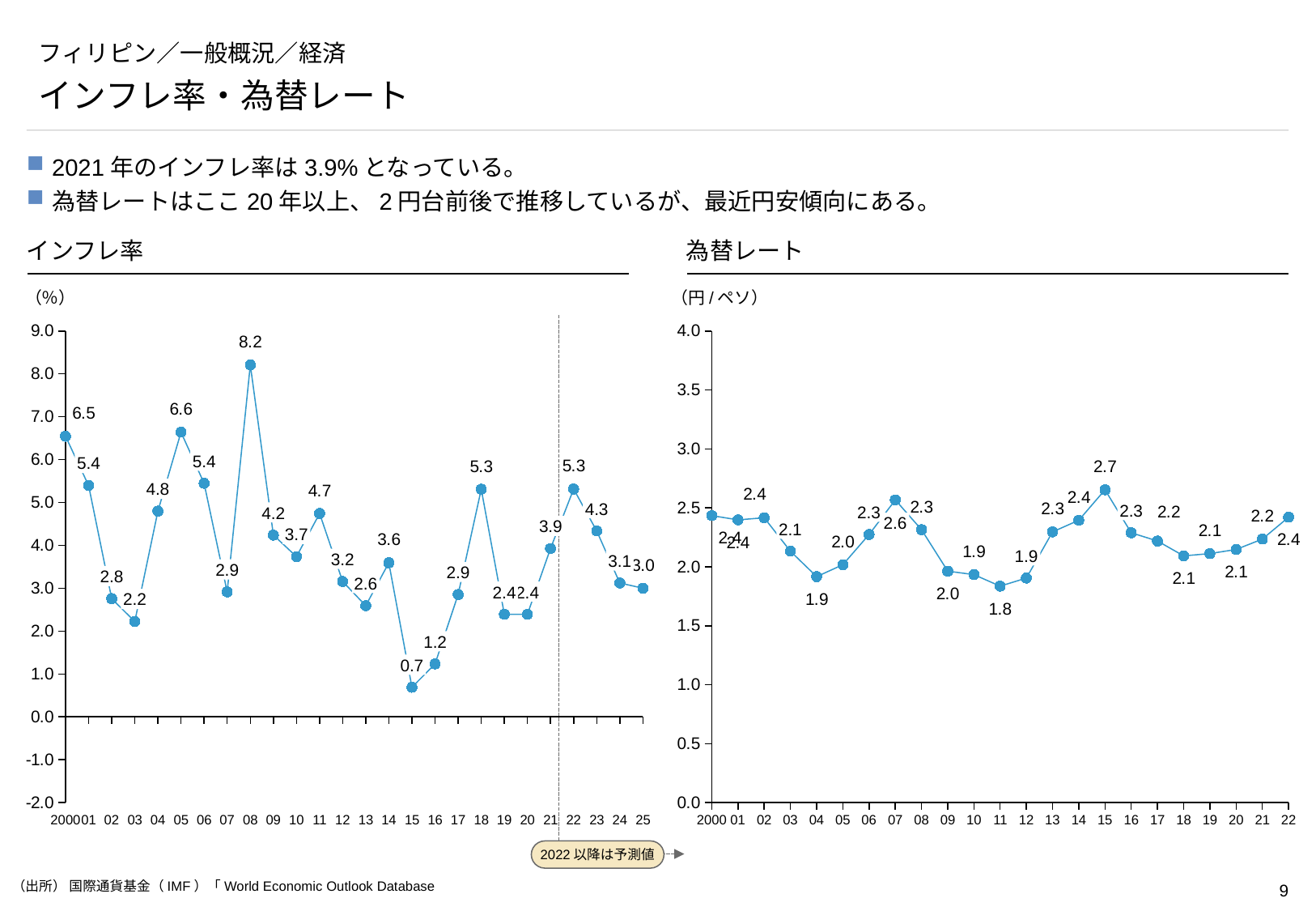
In the 為替レート chart, what is the value for 2015? 2.7 In the 為替レート chart, what is the difference between the 2015 value and the 2011 value? 0.9 In the インフレ率 chart, which year has the lowest inflation rate? 2015 In the インフレ率 chart, which year has the highest inflation rate? 2008 In the インフレ率 chart, what is the inflation rate for 2021? 3.9 In the インフレ率 chart, how many years are plotted? 26 In the インフレ率 chart, which is larger, the value for 2005 or the value for 2000? 2005 In the 為替レート chart, how many years are plotted? 23 In the インフレ率 chart, what is the inflation rate for 2008? 8.2 In the インフレ率 chart, what is the difference between the 2018 value and the 2019 value? 2.9 In the 為替レート chart, which year has the lowest value? 2011 What type of chart is the 為替レート chart? Line chart